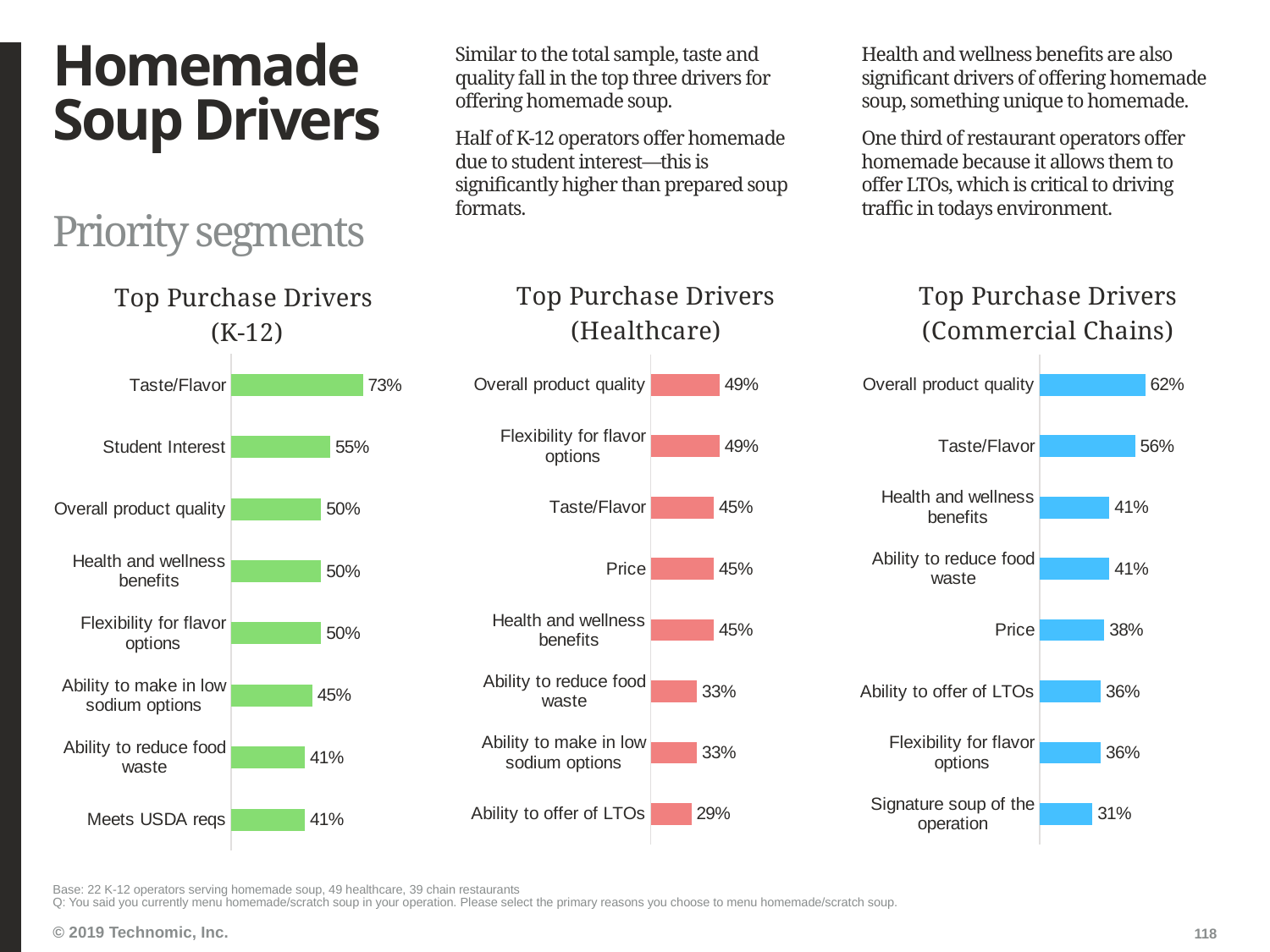
What kind of chart is the Top Purchase Drivers (K-12) chart? Bar chart In the Top Purchase Drivers (K-12) chart, what is the difference between Taste/Flavor and Student Interest? 18% In the Top Purchase Drivers (Commercial Chains) chart, what is the value for Signature soup of the operation? 31% What colour are the bars in the Top Purchase Drivers (Healthcare) chart? Red In the Top Purchase Drivers (Commercial Chains) chart, which category has the highest value? Overall product quality In the Top Purchase Drivers (K-12) chart, what is the value for Student Interest? 55% In the Top Purchase Drivers (K-12) chart, what is the value for Taste/Flavor? 73% How many categories are shown in the Top Purchase Drivers (Commercial Chains) chart? 8 In the Top Purchase Drivers (Healthcare) chart, which category has the lowest value? Ability to offer of LTOs In the Top Purchase Drivers (Healthcare) chart, which is larger: Overall product quality or Ability to reduce food waste? Overall product quality In the Top Purchase Drivers (Commercial Chains) chart, what is the difference between Overall product quality and Taste/Flavor? 6% In the Top Purchase Drivers (Healthcare) chart, what is the value for Price? 45%